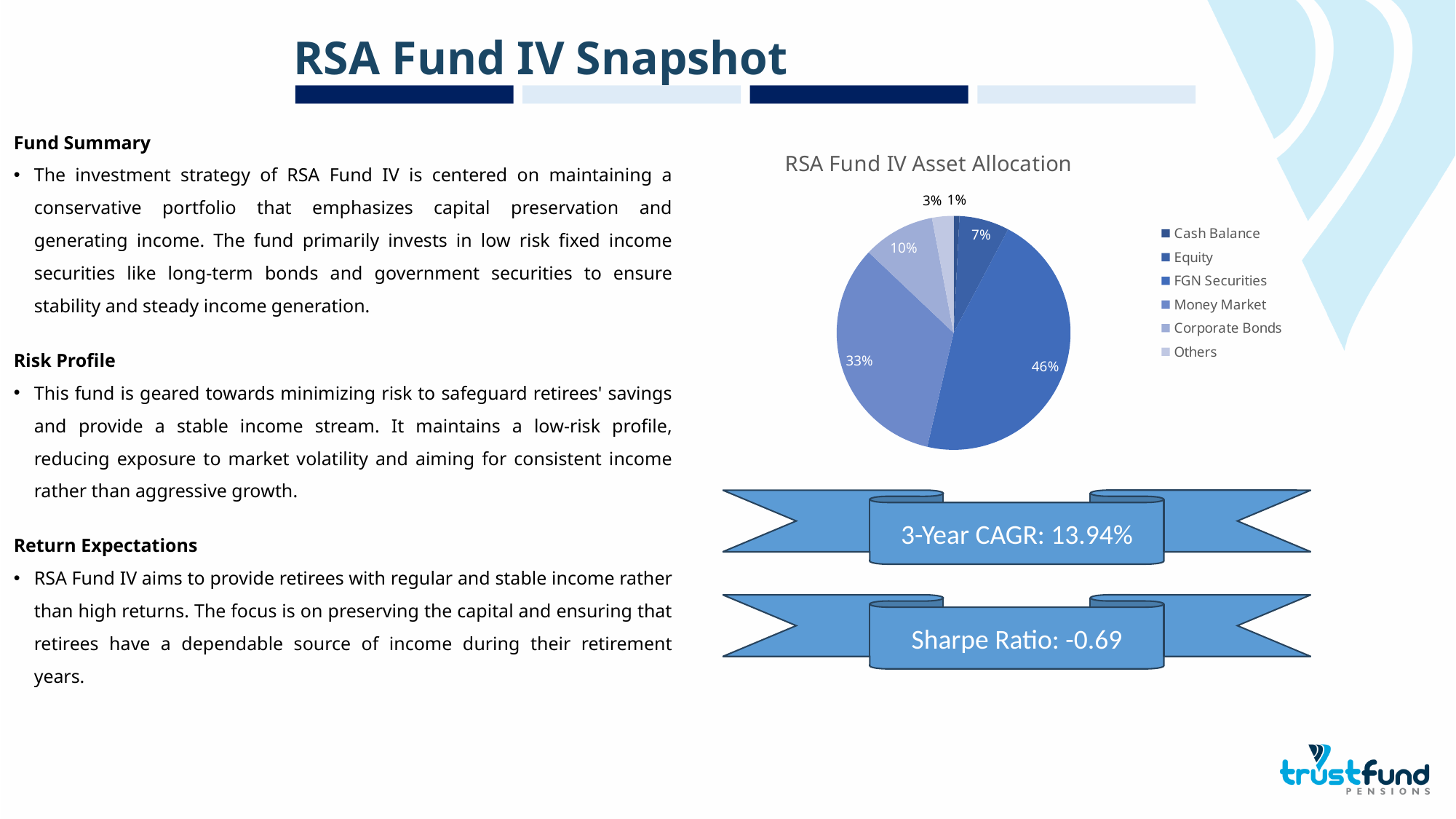
What type of chart is shown on the slide? pie chart Which category has the largest share of the pie? FGN Securities Which category has the smallest share of the pie? Cash Balance What is the smallest percentage shown on the pie chart? 1% What is the difference between the 46% slice and the 33% slice? 13 percentage points What is the largest percentage shown on the pie chart? 46% What is the combined share of the two largest slices (46% and 33%)? 79% Which is larger, the FGN Securities slice or the Corporate Bonds slice? FGN Securities What share of the pie is Money Market? 33% What is the title of the chart? RSA Fund IV Asset Allocation How many categories does the chart's legend list? 6 What share of the pie is Cash Balance? 1%